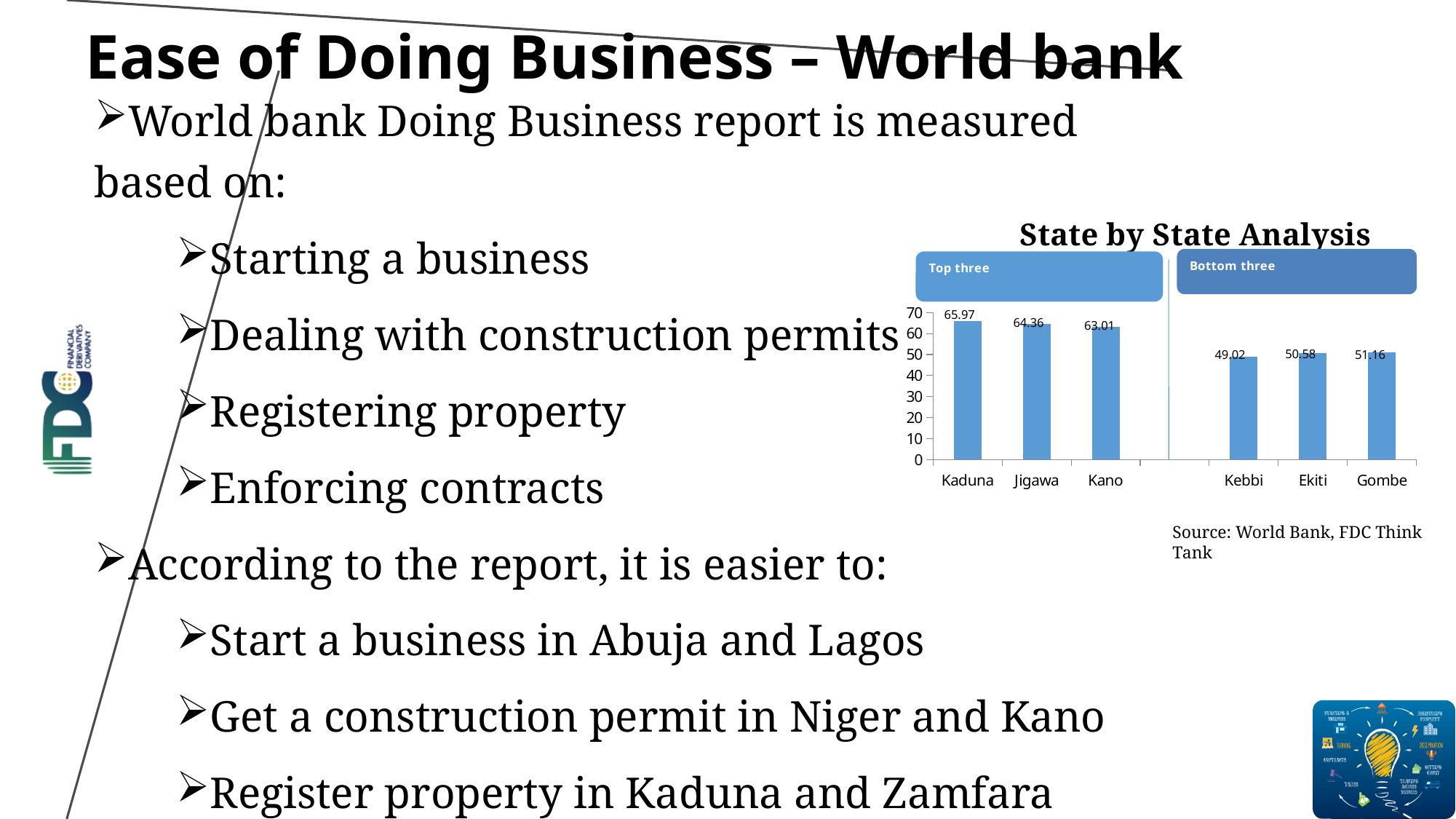
Which state has the highest value in the State by State Analysis chart? Kaduna What is the value for Gombe in the State by State Analysis chart? 51.16 What is the difference between the values for Gombe and Kebbi in the State by State Analysis chart? 2.14 What are the two group labels shown above the bars in the State by State Analysis chart? Top three and Bottom three What kind of chart is the State by State Analysis chart? Bar chart What is the value for Kebbi in the State by State Analysis chart? 49.02 Is the value for Kano in the State by State Analysis chart greater or less than 60? greater How many states are shown in the State by State Analysis chart? 6 What is the value for Kaduna in the State by State Analysis chart? 65.97 Which has a larger value in the State by State Analysis chart, Jigawa or Ekiti? Jigawa What is the difference between the values for Kaduna and Kano in the State by State Analysis chart? 2.96 Which state has the lowest value in the State by State Analysis chart? Kebbi